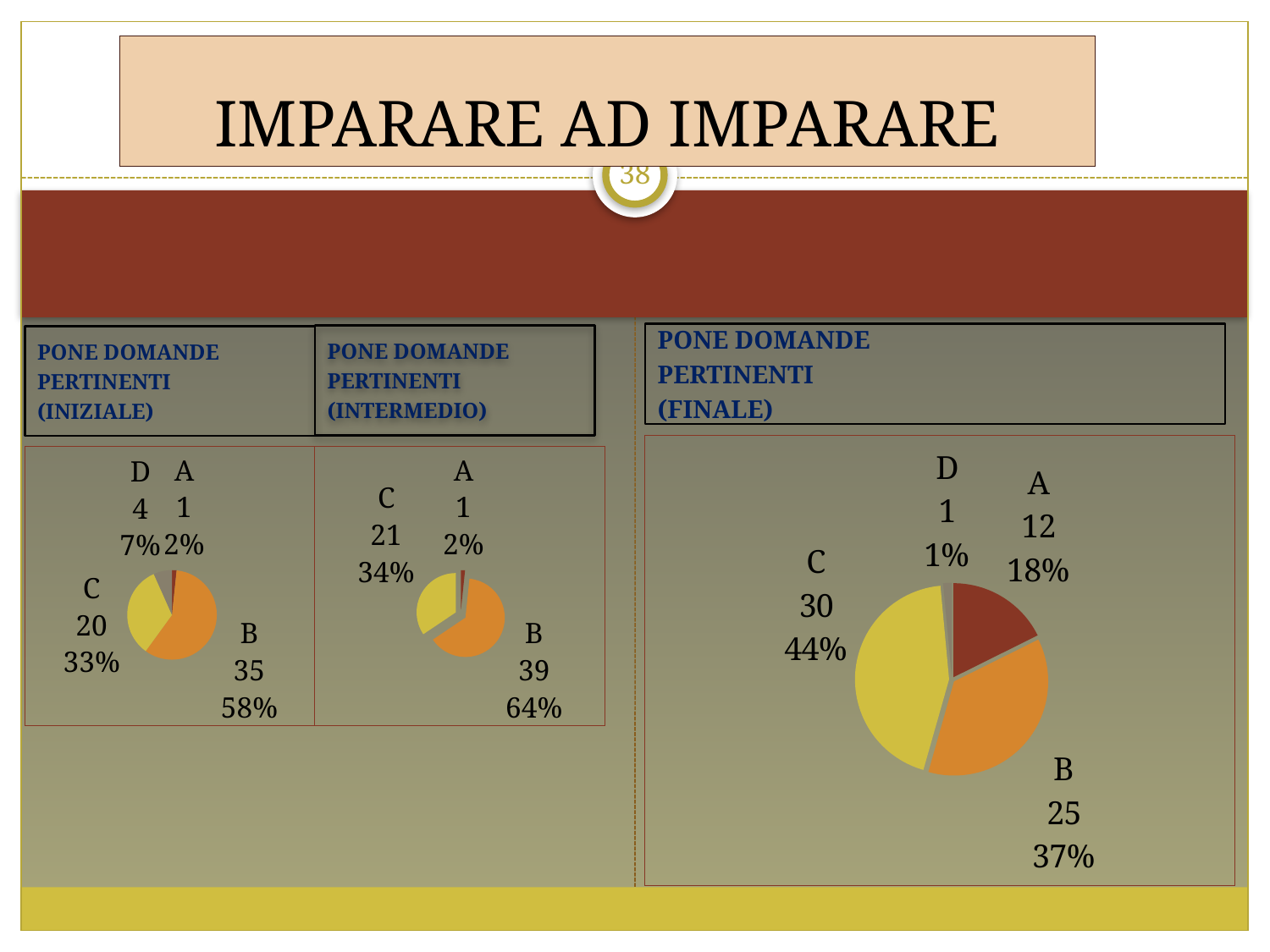
In the PONE DOMANDE PERTINENTI (FINALE) chart, what is the value for category A? 12 In the PONE DOMANDE PERTINENTI (INTERMEDIO) chart, which category has the highest value? B In the PONE DOMANDE PERTINENTI (FINALE) chart, what is the difference between the values for C and A? 18 In the PONE DOMANDE PERTINENTI (INIZIALE) chart, which category has the lowest value? A In the PONE DOMANDE PERTINENTI (INTERMEDIO) chart, what is the value for category C? 21 In the PONE DOMANDE PERTINENTI (INIZIALE) chart, what is the value for category B? 35 In the PONE DOMANDE PERTINENTI (FINALE) chart, which category has the largest share? C In the PONE DOMANDE PERTINENTI (INTERMEDIO) chart, what percentage share does category B have? 64% In the PONE DOMANDE PERTINENTI (FINALE) chart, which is larger, the value for B or the value for C? C In the PONE DOMANDE PERTINENTI (INIZIALE) chart, what is the difference between the values for B and C? 15 In the PONE DOMANDE PERTINENTI (INIZIALE) chart, what percentage share does category C have? 33% What type of chart is used for PONE DOMANDE PERTINENTI (FINALE)? Pie chart